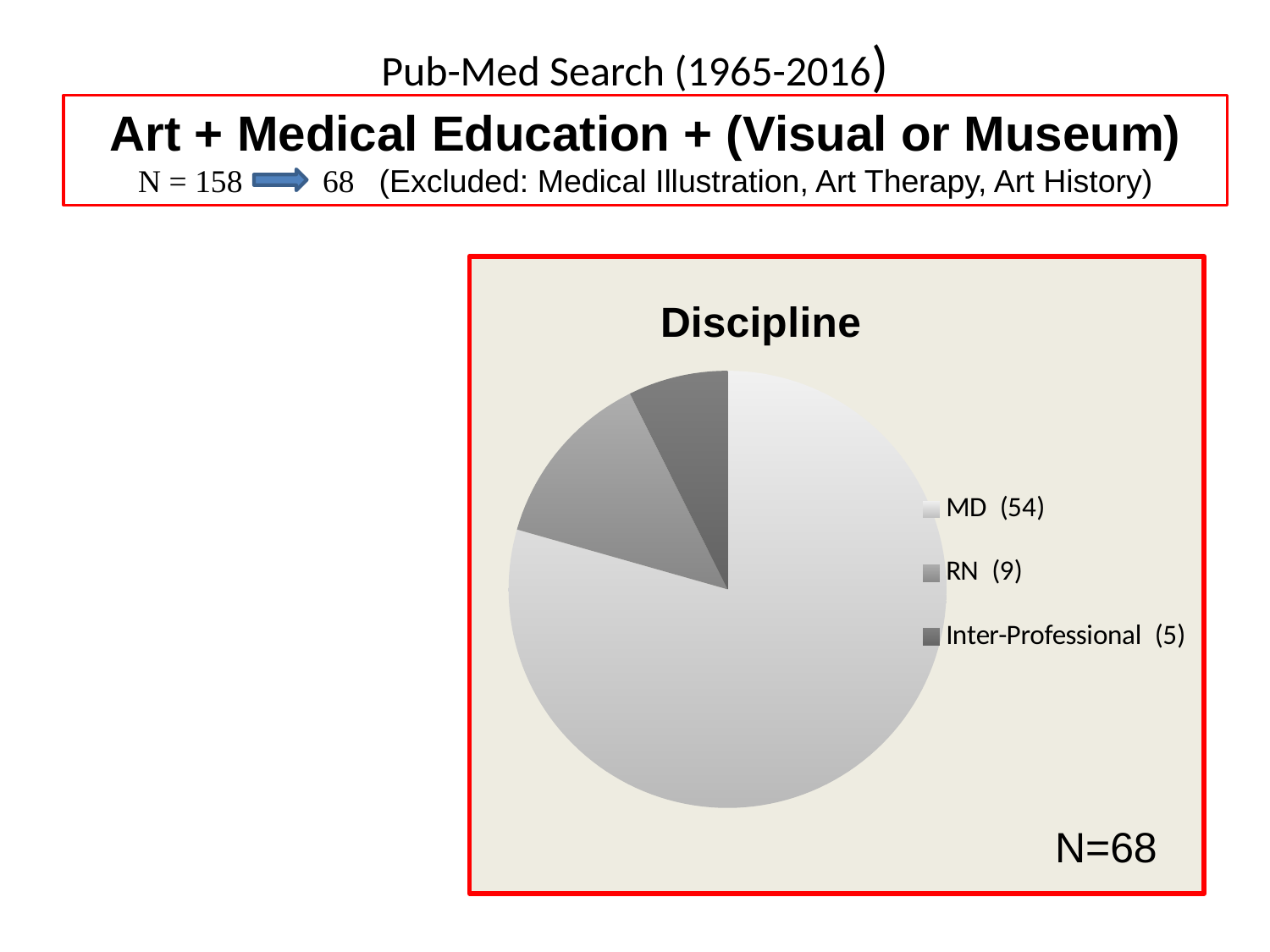
What is the total N shown for the Discipline pie chart? N=68 Which is larger, the value for RN or the value for Inter-Professional? RN What type of chart is shown on the slide? pie chart What is the difference between the MD and RN values? 45 What is the title of the chart? Discipline Which category has the largest slice of the pie? MD What is the value for MD in the Discipline pie chart? 54 Which category has the smallest slice of the pie? Inter-Professional How many categories does the pie chart have? 3 What is the difference between the RN and Inter-Professional values? 4 What is the value for RN in the Discipline pie chart? 9 What is the value for Inter-Professional in the Discipline pie chart? 5